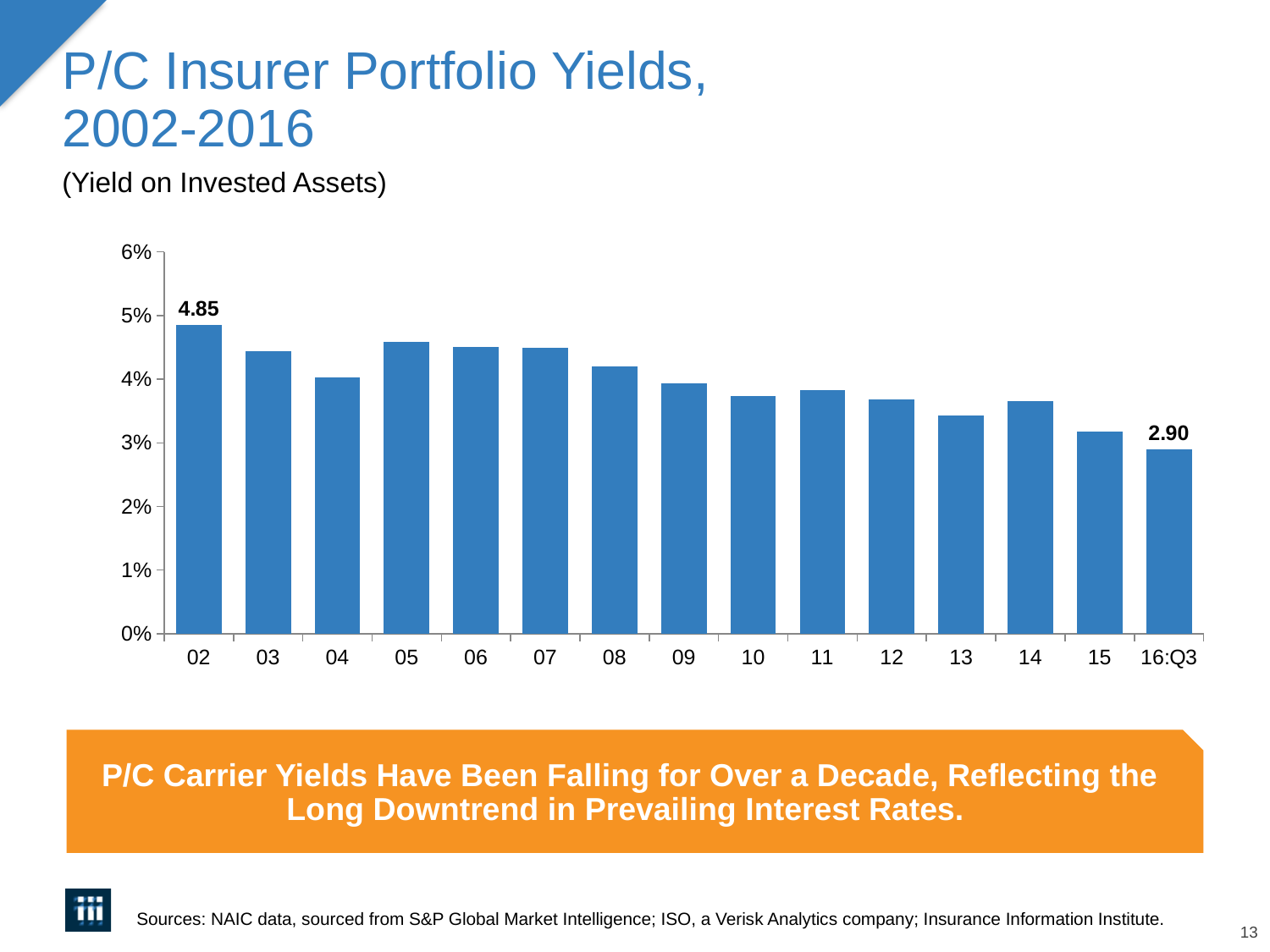
Which year has the highest portfolio yield? 02 Which period has the lowest portfolio yield? 16:Q3 Which is larger, the yield for 03 or the yield for 04? 03 What is the yield on invested assets shown for 16:Q3? 2.90 What is the yield on invested assets shown for 02? 4.85 Is the value for 08 greater or less than 4%? greater Is the value for 13 greater or less than 4%? less What kind of chart is shown on the slide? bar chart How many bars are plotted in the chart? 15 Do the portfolio yields generally rise or fall from 02 to 16:Q3? fall What is the difference between the yield in 02 and the yield in 16:Q3? 1.95 What is the highest value shown on the vertical axis? 6%